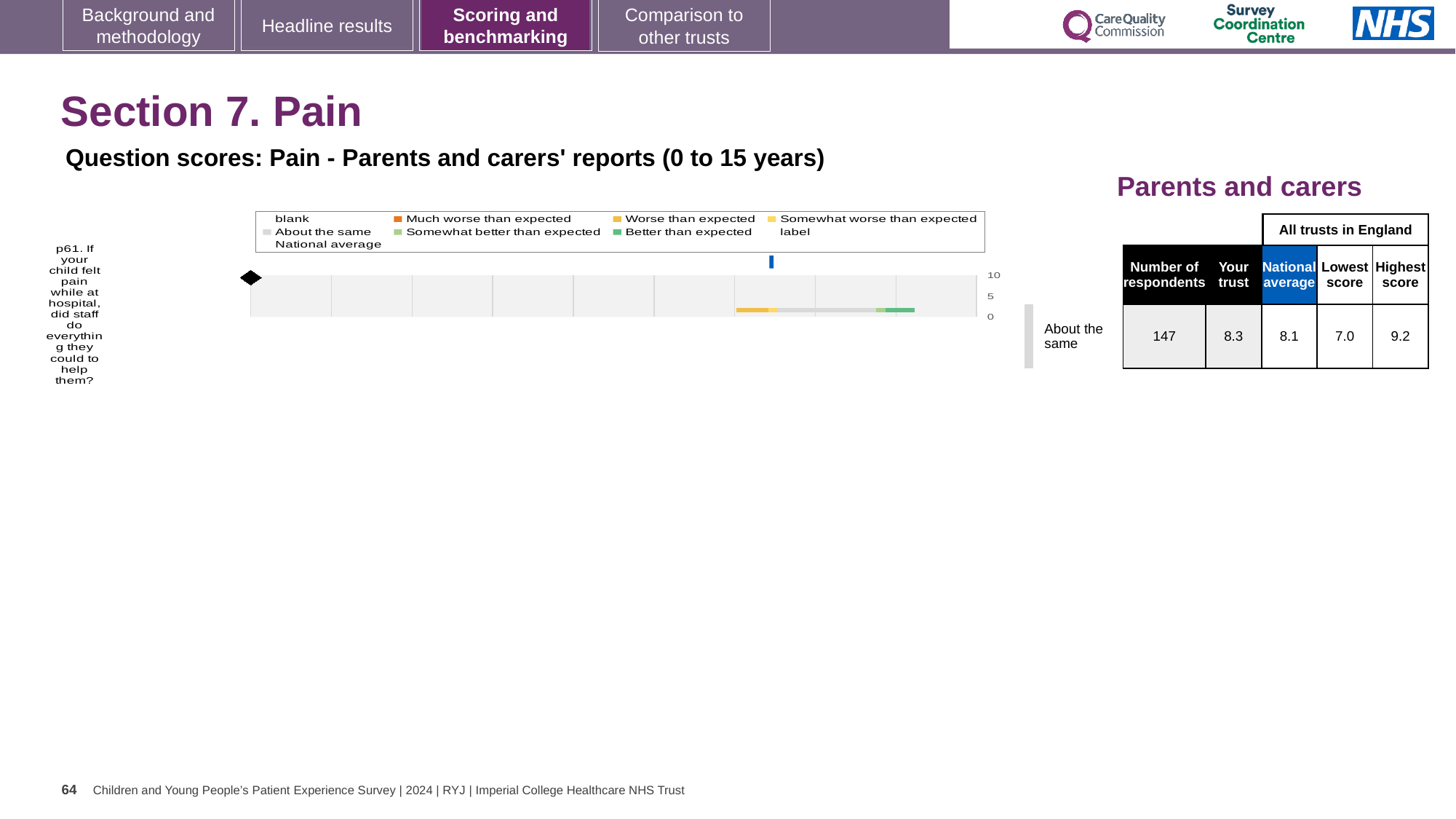
How many survey questions are plotted in the chart? 1 What kind of chart is shown on the slide? bar chart In the table beside the chart, what is the highest score among all trusts in England for p61? 9.2 Is the national average marker for p61 greater or less than 5 on the axis? greater In the table beside the chart, what is the lowest score among all trusts in England for p61? 7.0 What benchmark category is shown for p61 next to the chart? About the same In the table beside the chart, what is the number of respondents for p61? 147 What is the difference between the highest score and the lowest score for p61? 2.2 In the table beside the chart, what is the 'Your trust' score for p61? 8.3 In the table beside the chart, what is the national average score for p61? 8.1 What is the heading above the chart? Question scores: Pain - Parents and carers' reports (0 to 15 years) Which is larger for p61, the 'Your trust' score or the national average? Your trust